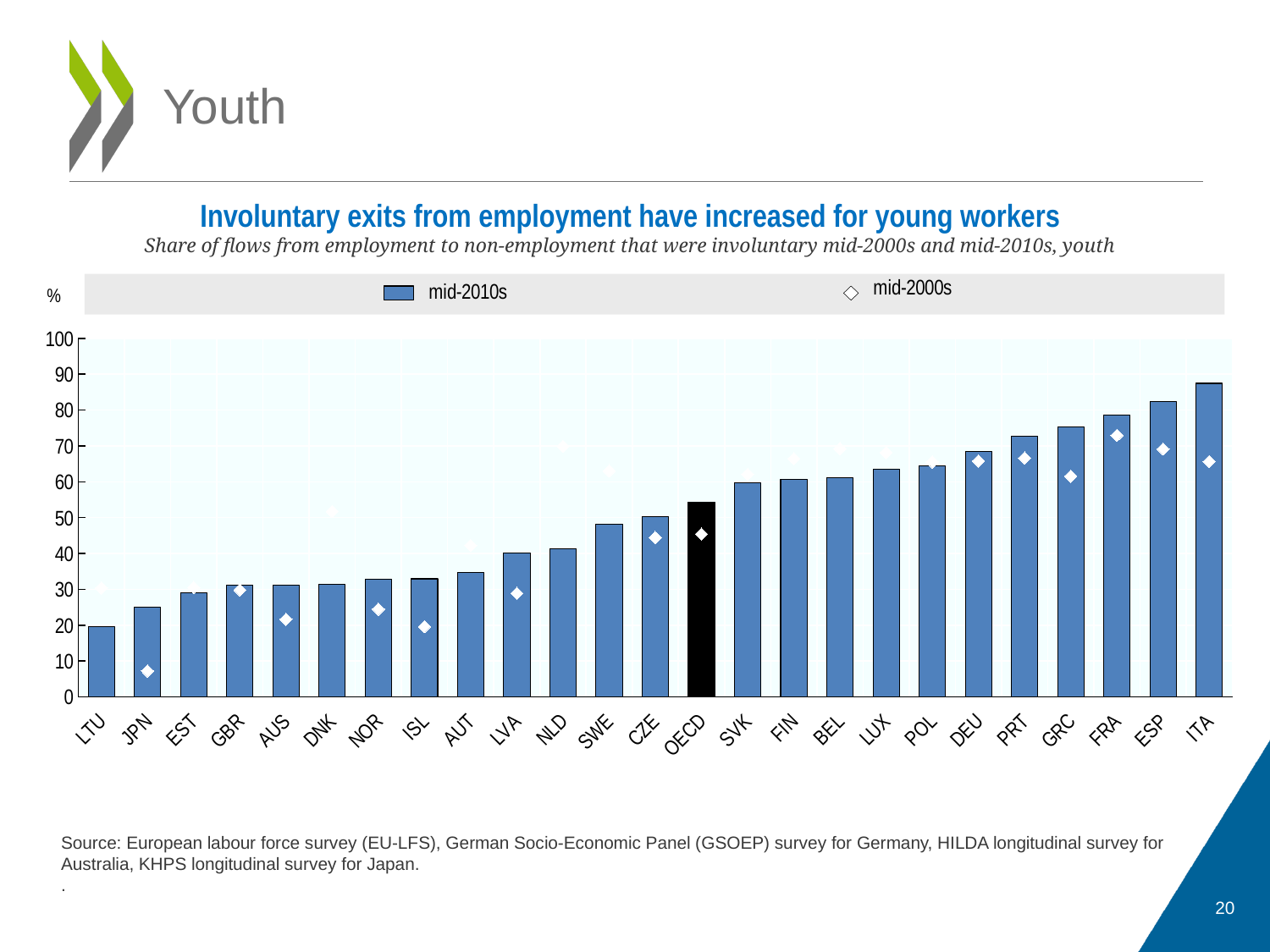
Which category has the highest mid-2010s bar? ITA Which category has the lowest mid-2010s bar? LTU Is the mid-2010s value for OECD greater or less than 50? greater Is the mid-2000s value for JPN greater or less than 10? less Is the mid-2010s value for ITA greater or less than 80? greater How many series does the legend list? 2 Which is larger, the mid-2010s value for ESP or for SVK? ESP What is the title of the chart? Involuntary exits from employment have increased for young workers How many categories are shown along the x axis? 25 Do the mid-2010s bars rise or fall from left to right along the x axis? rise What kind of chart is shown on the slide? bar chart